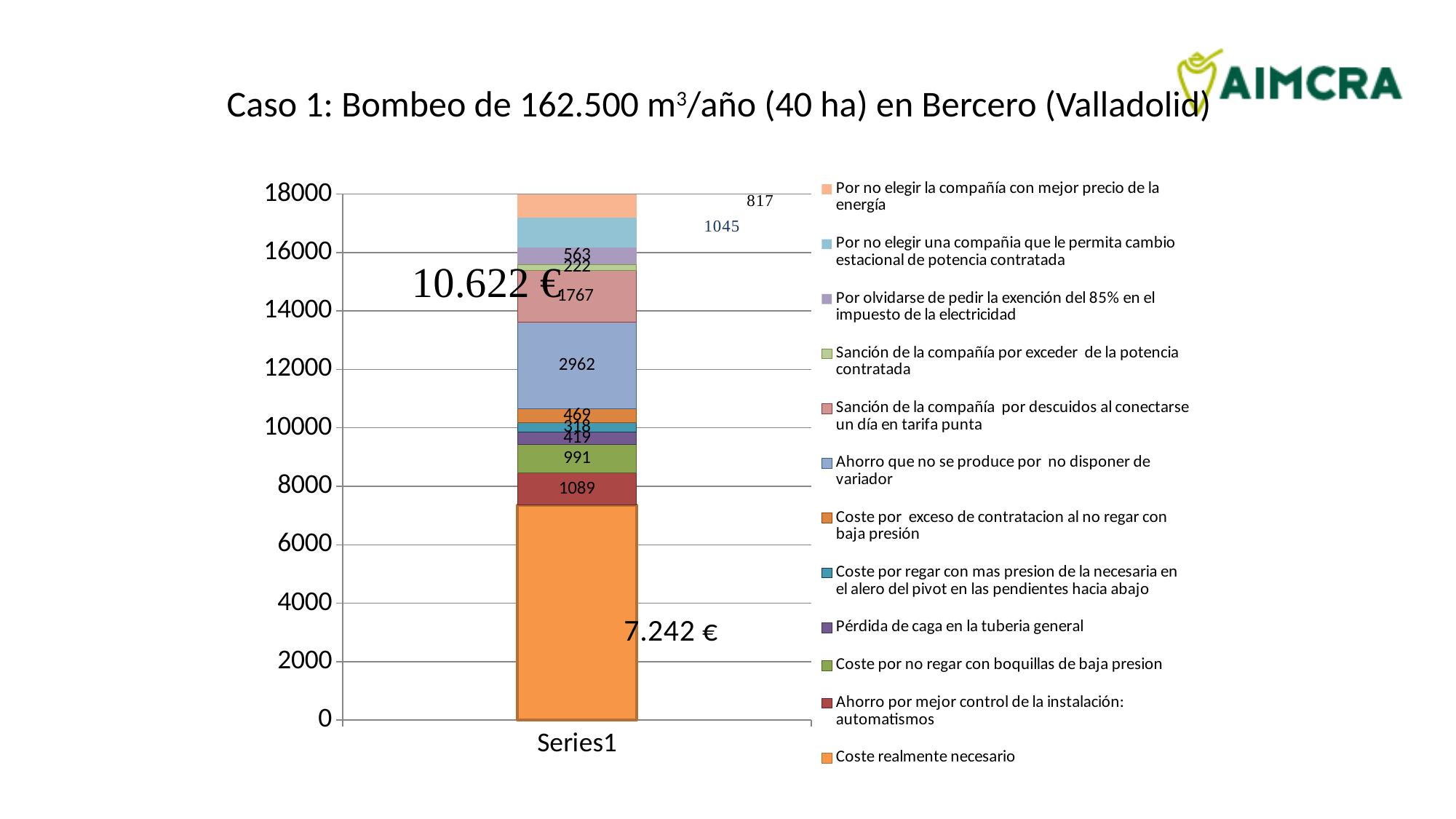
How many series does the legend list? 12 Which labelled segment has the smallest value? Sanción de la compañía por exceder de la potencia contratada (222) What kind of chart is shown on the slide? Stacked bar chart What is the value of the segment 'Sanción de la compañía por exceder de la potencia contratada'? 222 Which is larger: 'Ahorro por mejor control de la instalación: automatismos' or 'Coste por no regar con boquillas de baja presion'? Ahorro por mejor control de la instalación: automatismos What is the value of the segment 'Ahorro que no se produce por no disponer de variador'? 2962 What is the value of the segment 'Sanción de la compañía por descuidos al conectarse un día en tarifa punta'? 1767 Which segment of the stacked bar is the largest? Coste realmente necesario What is the difference between the 'variador' segment (2962) and the 'tarifa punta' segment (1767)? 1195 What is the value of the segment 'Ahorro por mejor control de la instalación: automatismos'? 1089 What is the value of the segment 'Por no elegir la compañía con mejor precio de la energía'? 817 How many categories are plotted on the x axis? 1